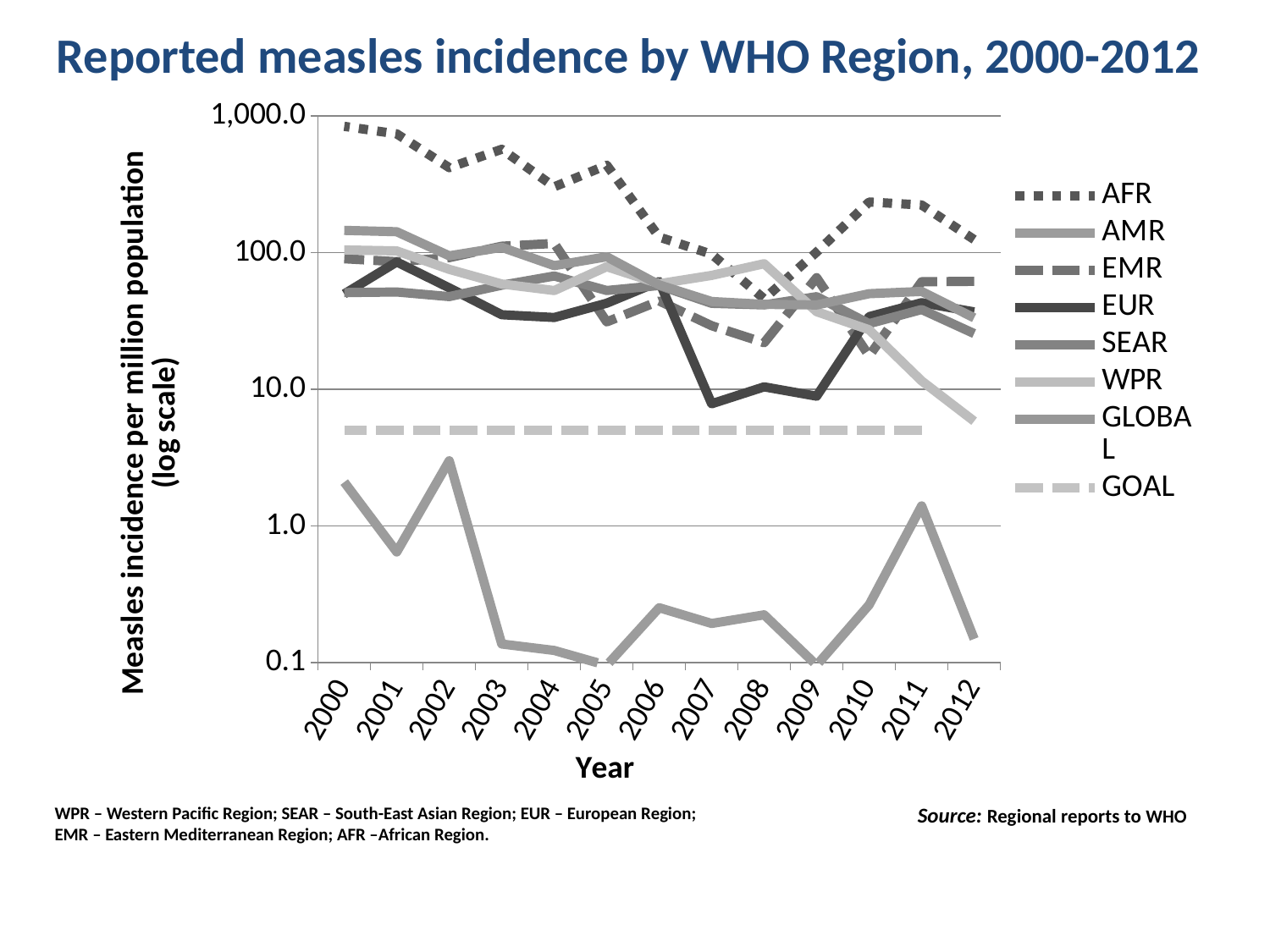
Is the value for AMR in 2003 greater or less than 1.0? less How many years are plotted along the x axis? 13 Does the AFR line rise or fall overall from 2000 to 2012? fall Is the value for WPR in 2012 greater or less than 10.0? less Is the value for AFR in 2000 greater or less than 100.0? greater In 2005, which is larger, the value for AFR or the value for AMR? AFR How many series does the legend list? 8 What is the title of the chart? Reported measles incidence by WHO Region, 2000-2012 Which region has the lowest reported measles incidence in 2000? AMR Which region has the highest reported measles incidence in 2000? AFR What kind of chart is shown on the slide? line chart